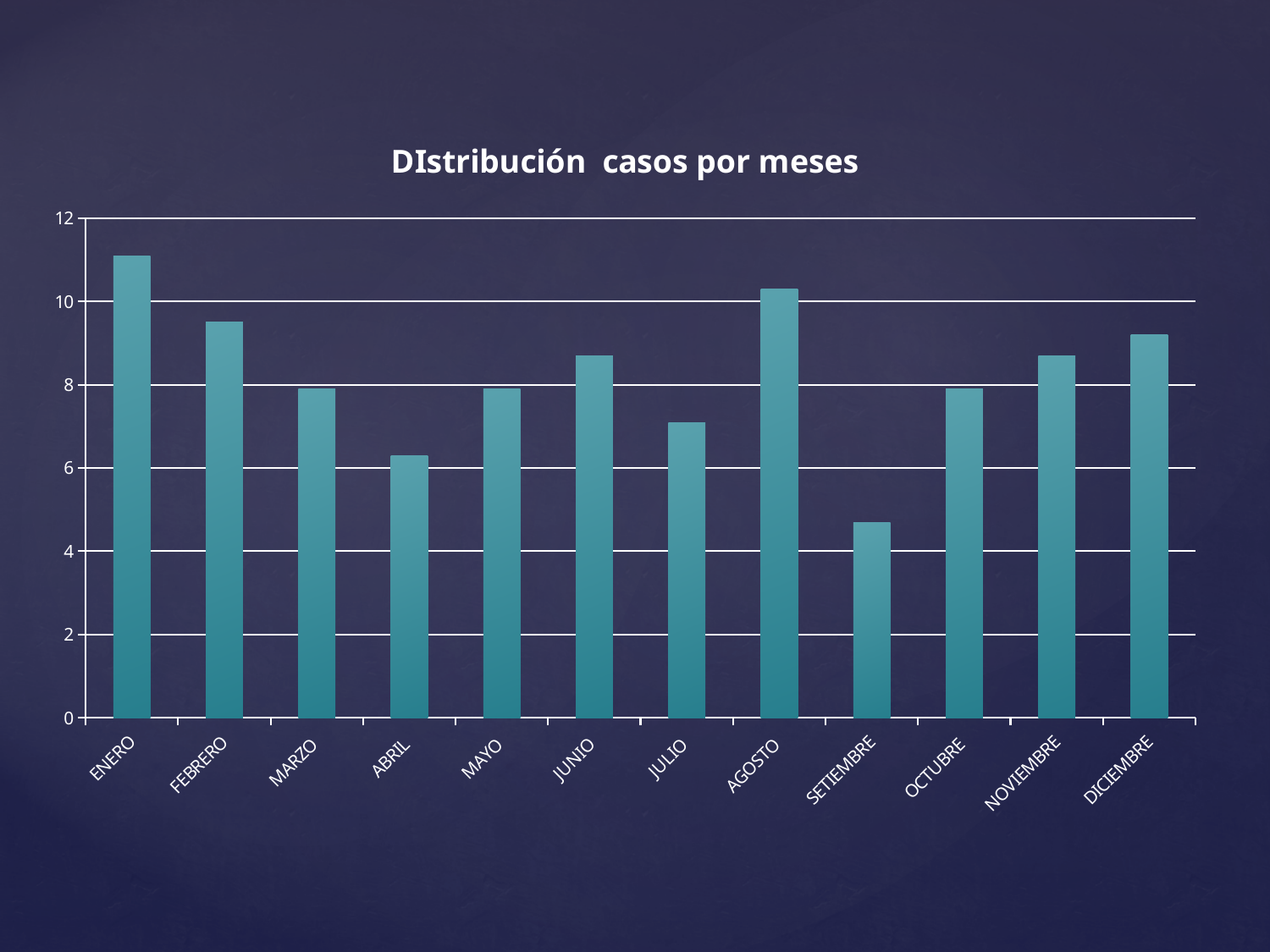
What is the title of the chart? DIstribución casos por meses What type of chart is shown on the slide? bar chart Is the value for ENERO greater or less than 10? greater Which is larger, the value for FEBRERO or the value for JULIO? FEBRERO Is the value for ABRIL greater or less than 8? less How many months are shown on the x axis of the chart? 12 Is the value for SETIEMBRE greater or less than 6? less Which month has the highest value in the chart? ENERO What is the maximum value shown on the y axis of the chart? 12 Which is larger, the value for ABRIL or the value for DICIEMBRE? DICIEMBRE Which month has the lowest value in the chart? SETIEMBRE